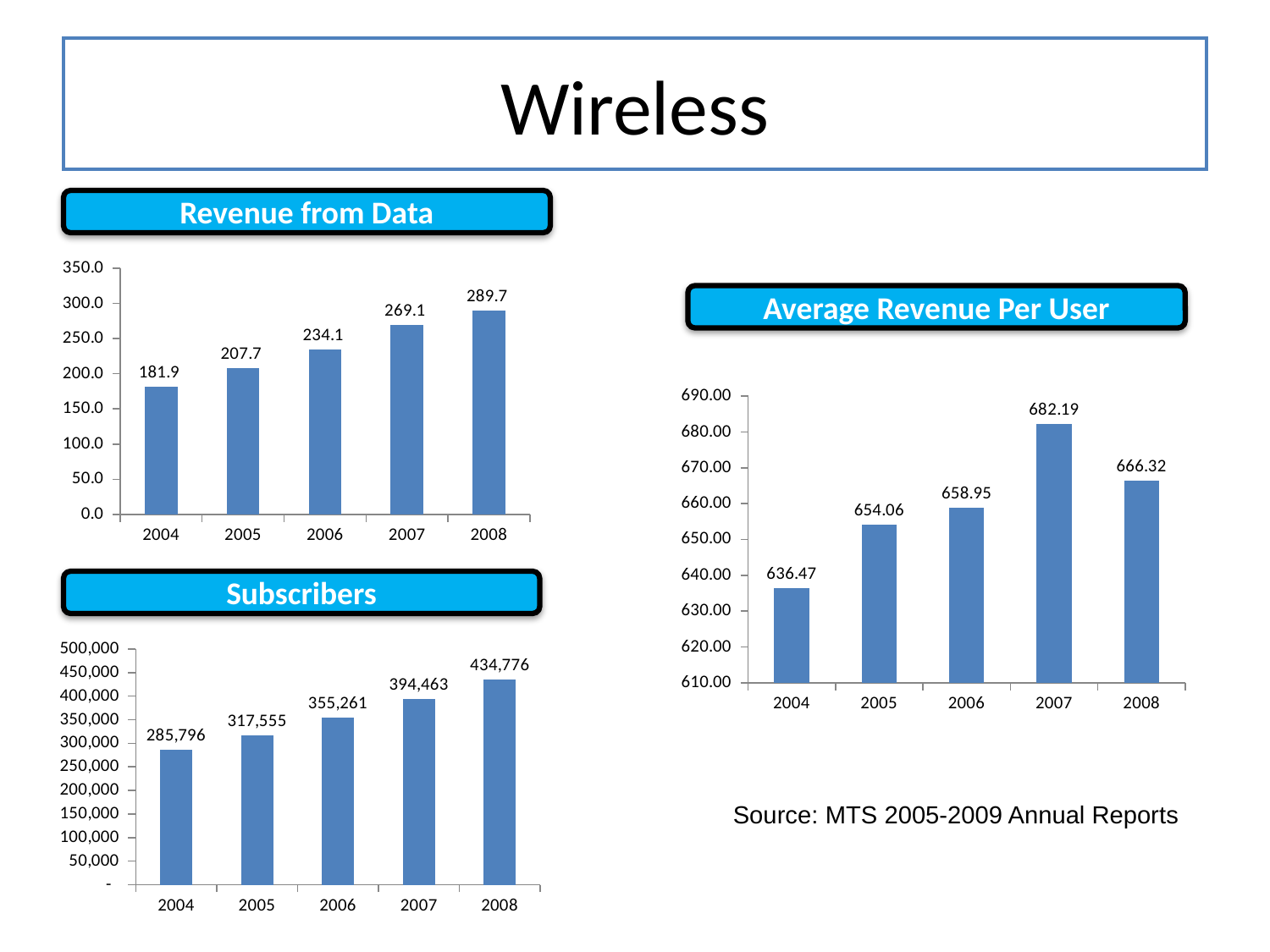
In the Average Revenue Per User chart, what is the value for 2005? 654.06 In the Revenue from Data chart, do the values rise or fall from 2004 to 2008? rise In the Average Revenue Per User chart, which year has the highest value? 2007 In the Subscribers chart, which year has the lowest value? 2004 In the Revenue from Data chart, what is the difference between the 2008 and 2004 values? 107.8 In the Subscribers chart, what is the difference between the 2006 and 2005 values? 37,706 In the Average Revenue Per User chart, which is larger, the value for 2006 or the value for 2008? 2008 In the Subscribers chart, what is the value for 2007? 394,463 What kind of chart is the Average Revenue Per User chart? bar chart In the Subscribers chart, how many years are shown on the x axis? 5 In the Revenue from Data chart, which year has the highest value? 2008 In the Revenue from Data chart, what is the value for 2006? 234.1